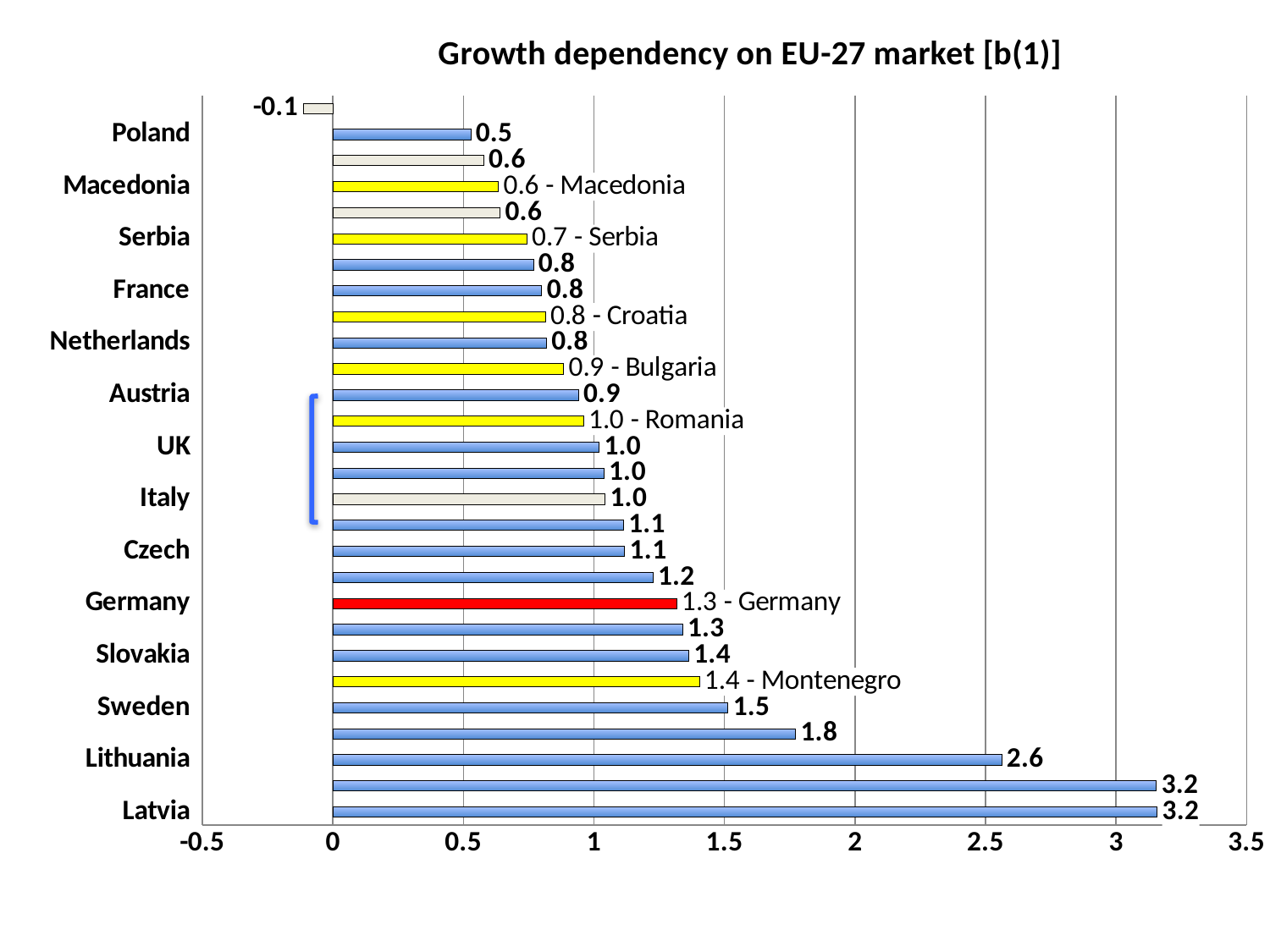
Which is larger, the value for Sweden or the value for Germany? Sweden What is the value for Germany? 1.3 What is the title of the chart? Growth dependency on EU-27 market [b(1)] Is the value for Lithuania greater or less than 2.5? greater What is the value for Croatia? 0.8 What is the value for Montenegro? 1.4 What is the value for Poland? 0.5 What is the difference between the values for Latvia and Lithuania? 0.6 What is the value for Lithuania? 2.6 What is the value for Latvia? 3.2 What is the difference between the values for Germany and Macedonia? 0.7 What kind of chart is shown on the slide? bar chart